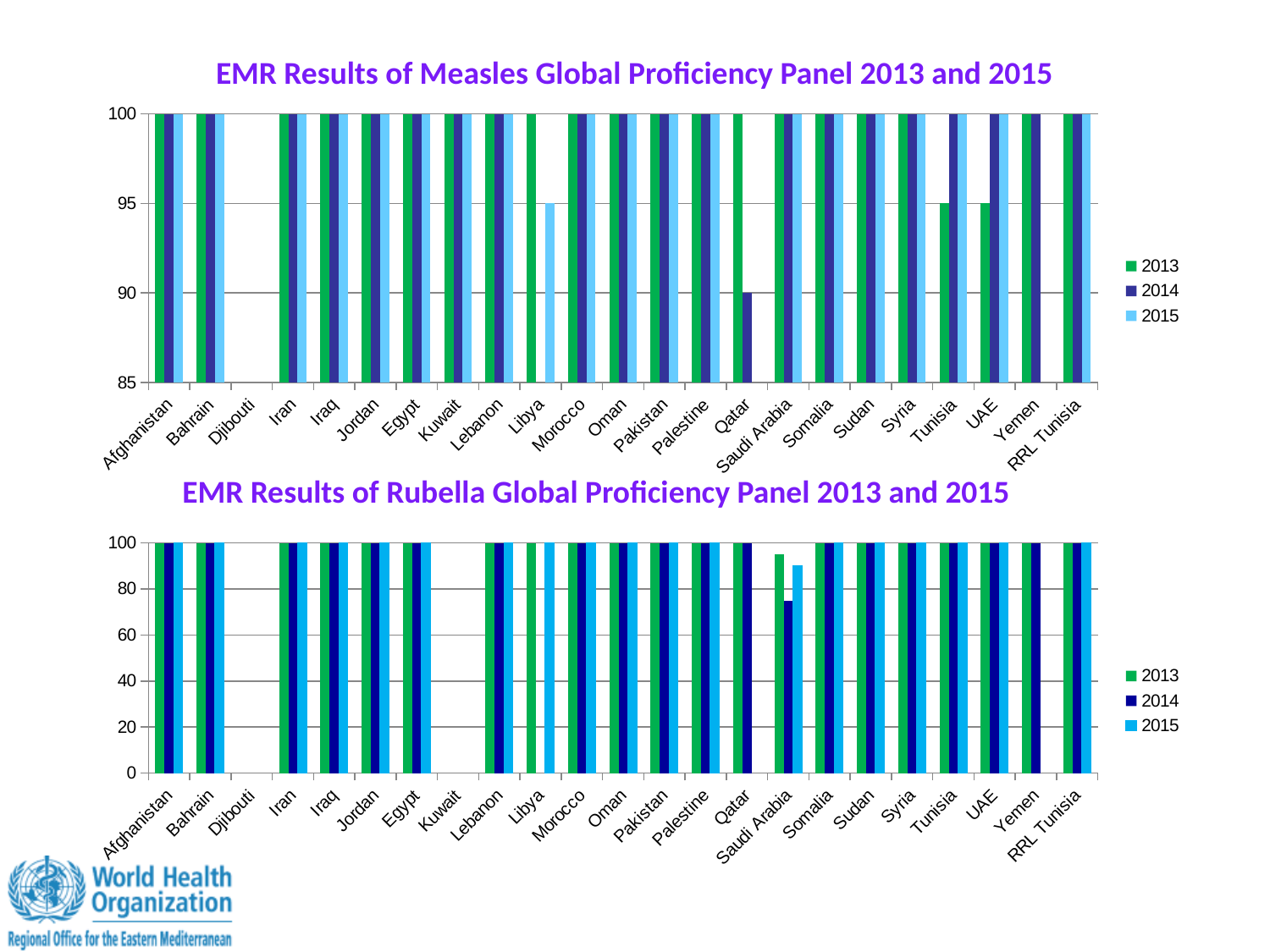
In the EMR Results of Measles Global Proficiency Panel 2013 and 2015 chart, which country has the lowest 2014 value? Qatar In the EMR Results of Measles Global Proficiency Panel 2013 and 2015 chart, what is the difference between the 2013 value for Afghanistan and the 2014 value for Qatar? 10 In the EMR Results of Measles Global Proficiency Panel 2013 and 2015 chart, what is the 2013 value for Tunisia? 95 In the EMR Results of Measles Global Proficiency Panel 2013 and 2015 chart, which is larger: the 2013 value for Afghanistan or the 2013 value for UAE? Afghanistan In the EMR Results of Rubella Global Proficiency Panel 2013 and 2015 chart, is the 2014 value for Saudi Arabia greater or less than 80? less What kind of chart is the EMR Results of Measles Global Proficiency Panel 2013 and 2015 chart? bar chart In the EMR Results of Measles Global Proficiency Panel 2013 and 2015 chart, what is the 2015 value for Libya? 95 How many countries are shown on the x axis of the EMR Results of Measles Global Proficiency Panel 2013 and 2015 chart? 23 In the EMR Results of Rubella Global Proficiency Panel 2013 and 2015 chart, is the 2013 value for Saudi Arabia greater or less than 80? greater How many series does the legend of the EMR Results of Rubella Global Proficiency Panel 2013 and 2015 chart list? 3 In the EMR Results of Measles Global Proficiency Panel 2013 and 2015 chart, what is the 2014 value for Qatar? 90 In the EMR Results of Rubella Global Proficiency Panel 2013 and 2015 chart, which country has the lowest 2014 value? Saudi Arabia